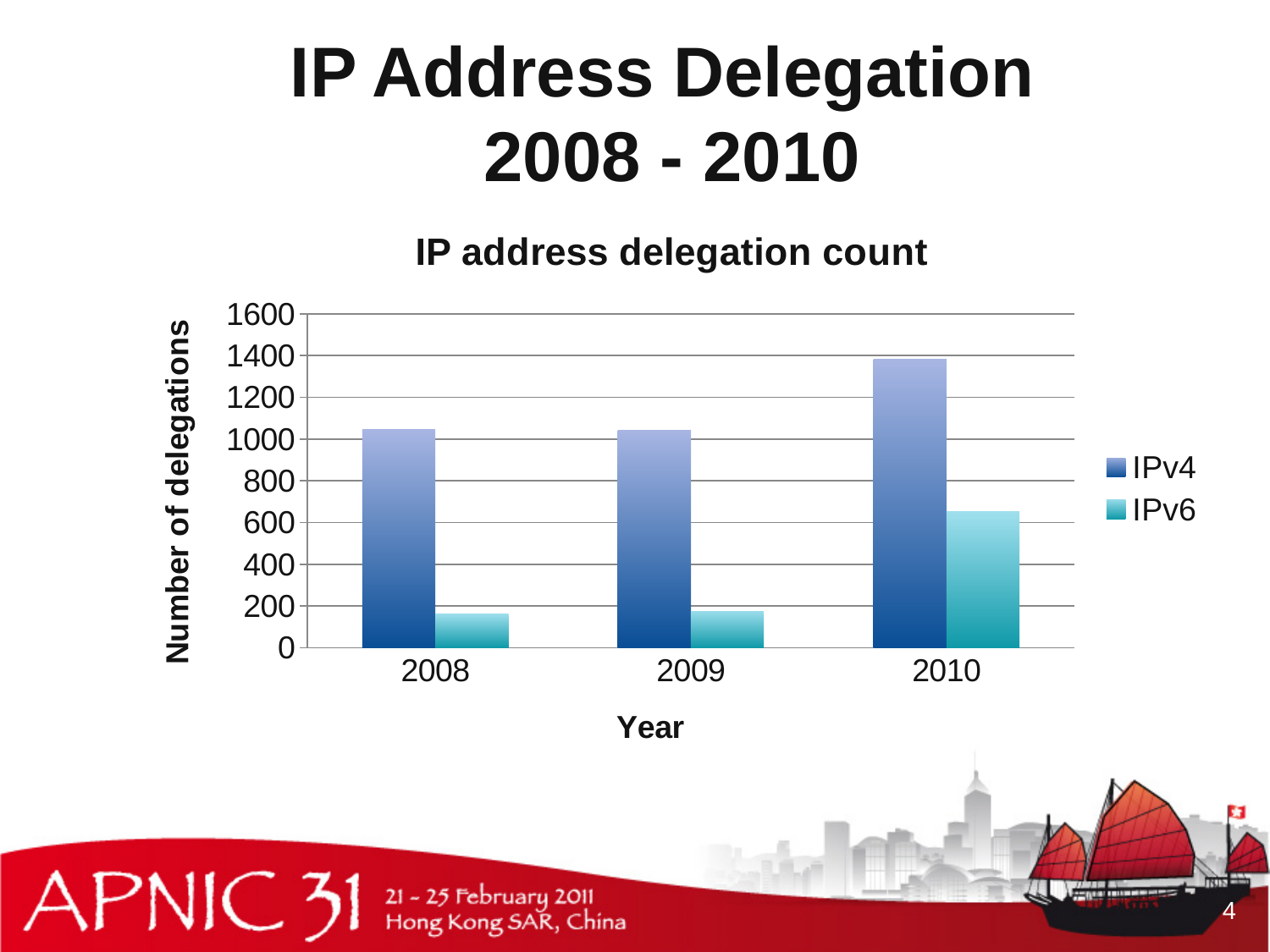
Which year has the highest IPv4 delegation count? 2010 What is the title of the chart? IP address delegation count How many years are shown on the x axis? 3 What kind of chart is shown on the slide? bar chart Is the IPv4 value for 2008 greater or less than 1000? greater Is the IPv4 value for 2010 greater or less than 1200? greater In 2010, which is larger, the IPv4 or the IPv6 delegation count? IPv4 Is the IPv6 value for 2010 greater or less than 400? greater Which year has the highest IPv6 delegation count? 2010 Do the IPv6 values rise or fall from 2008 to 2010? rise How many series does the legend list? 2